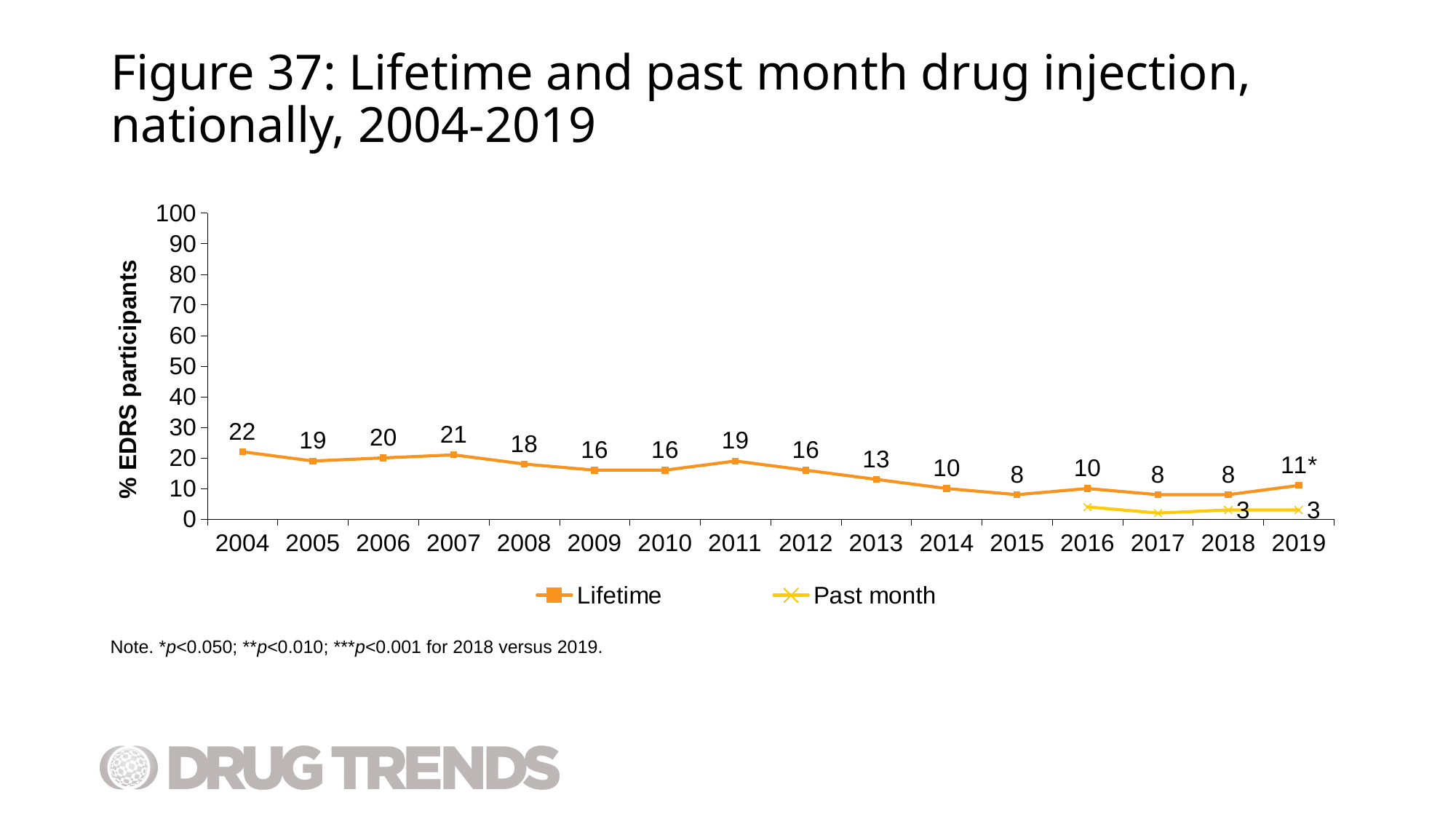
What is the Past month value for 2018? 3 How many series does the legend list? 2 Does the Lifetime series generally rise or fall from 2004 to 2018? fall What kind of chart is shown? line chart Which is larger, the Lifetime value for 2007 or for 2011? 2007 How many years are shown on the x axis? 16 What is the Lifetime value for 2004? 22 Is the Past month value for 2016 greater or less than 10? less What is the difference between the Lifetime values for 2004 and 2015? 14 What is the Lifetime value for 2019? 11* What is the Lifetime value for 2013? 13 In which year is the Lifetime series highest? 2004